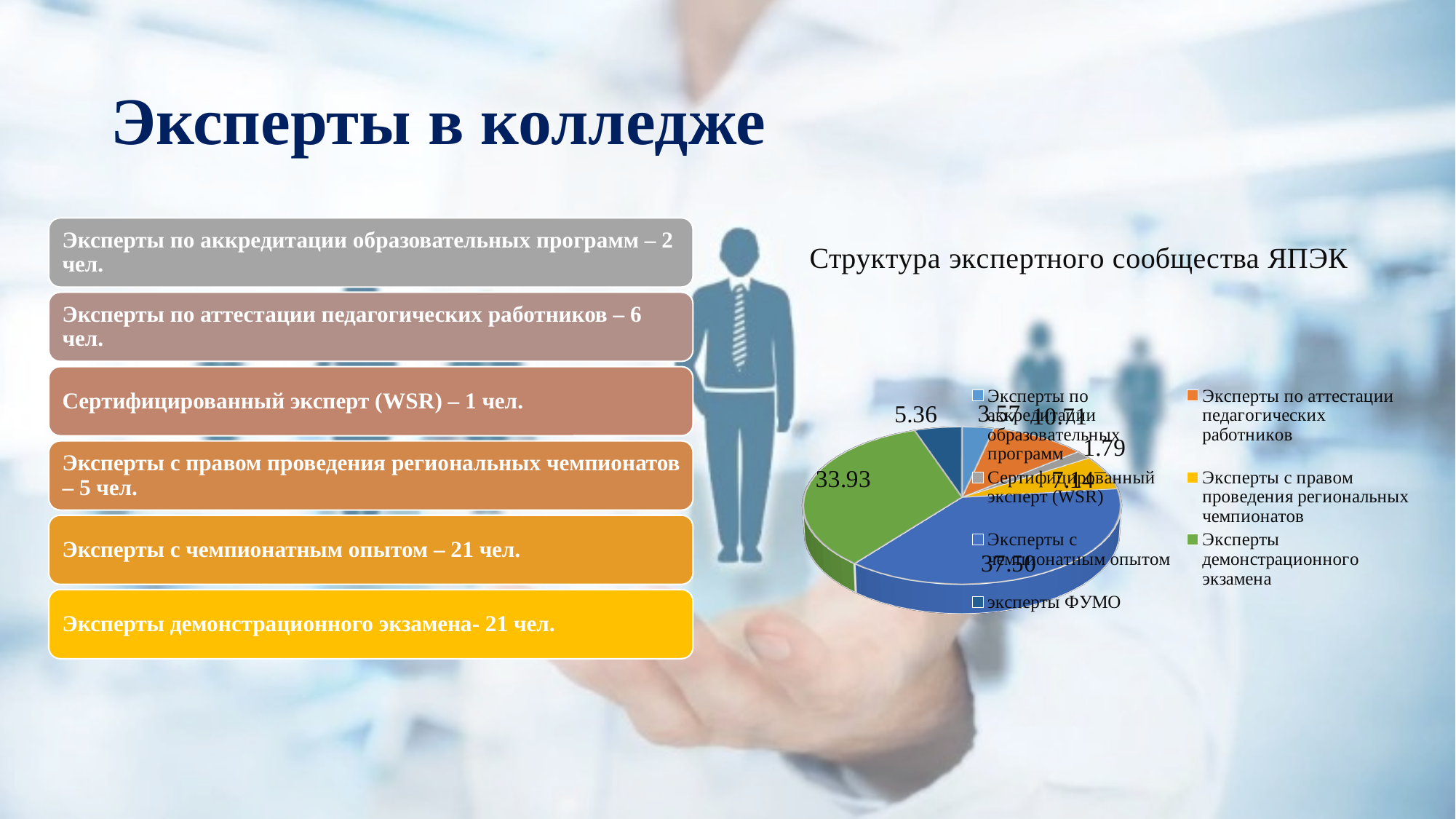
What kind of chart is shown on the slide? pie chart How many entries does the legend of the pie chart list? 7 What value is shown for Эксперты демонстрационного экзамена in the pie chart? 33.93 Which category has the smallest slice in the pie chart? Сертифицированный эксперт (WSR) What value is shown for эксперты ФУМО in the pie chart? 5.36 Which category has the largest slice in the pie chart? Эксперты с чемпионатным опытом What value is shown for Эксперты по аттестации педагогических работников in the pie chart? 10.71 What value is shown for Эксперты с чемпионатным опытом in the pie chart? 37.50 Which is larger in the pie chart: the value for эксперты ФУМО or the value for Эксперты по аттестации педагогических работников? Эксперты по аттестации педагогических работников What is the title of the pie chart? Структура экспертного сообщества ЯПЭК What is the difference between the values for Эксперты с чемпионатным опытом and Эксперты демонстрационного экзамена? 3.57 How many slices does the pie chart have? 7